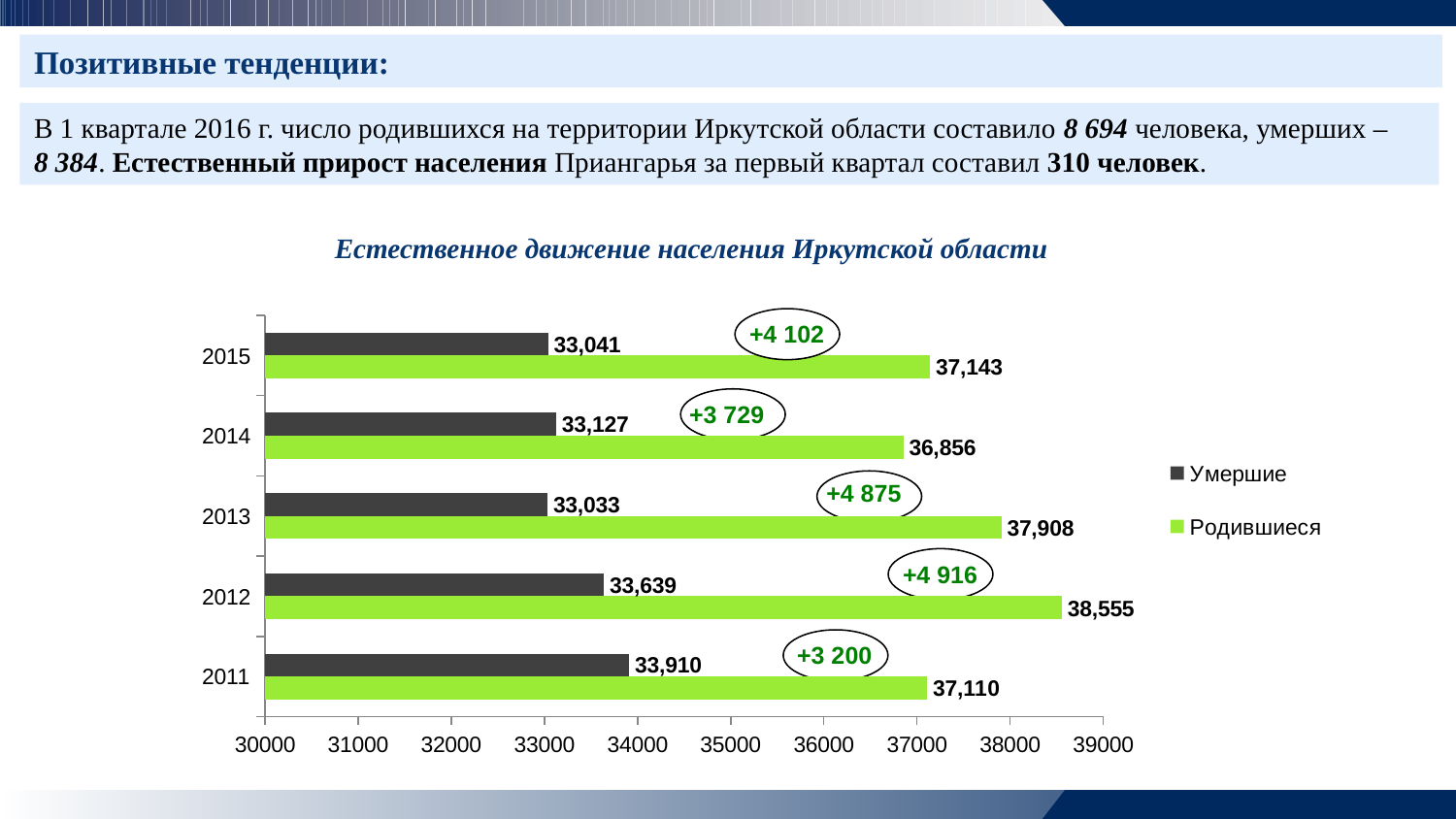
How many years are shown on the chart? 5 What is the title of the chart? Естественное движение населения Иркутской области In which year is the value for Умершие the highest? 2011 What is the value for Родившиеся in 2015? 37,143 What is the value for Умершие in 2011? 33,910 What type of chart is shown on the slide? Bar chart What is the difference between Родившиеся and Умершие in 2012? 4,916 Is the value for Родившиеся in 2013 greater or less than 37000? greater How many series does the legend list? 2 In which year is the value for Родившиеся the lowest? 2014 What is the value for Родившиеся in 2014? 36,856 In which year is the value for Родившиеся the highest? 2012